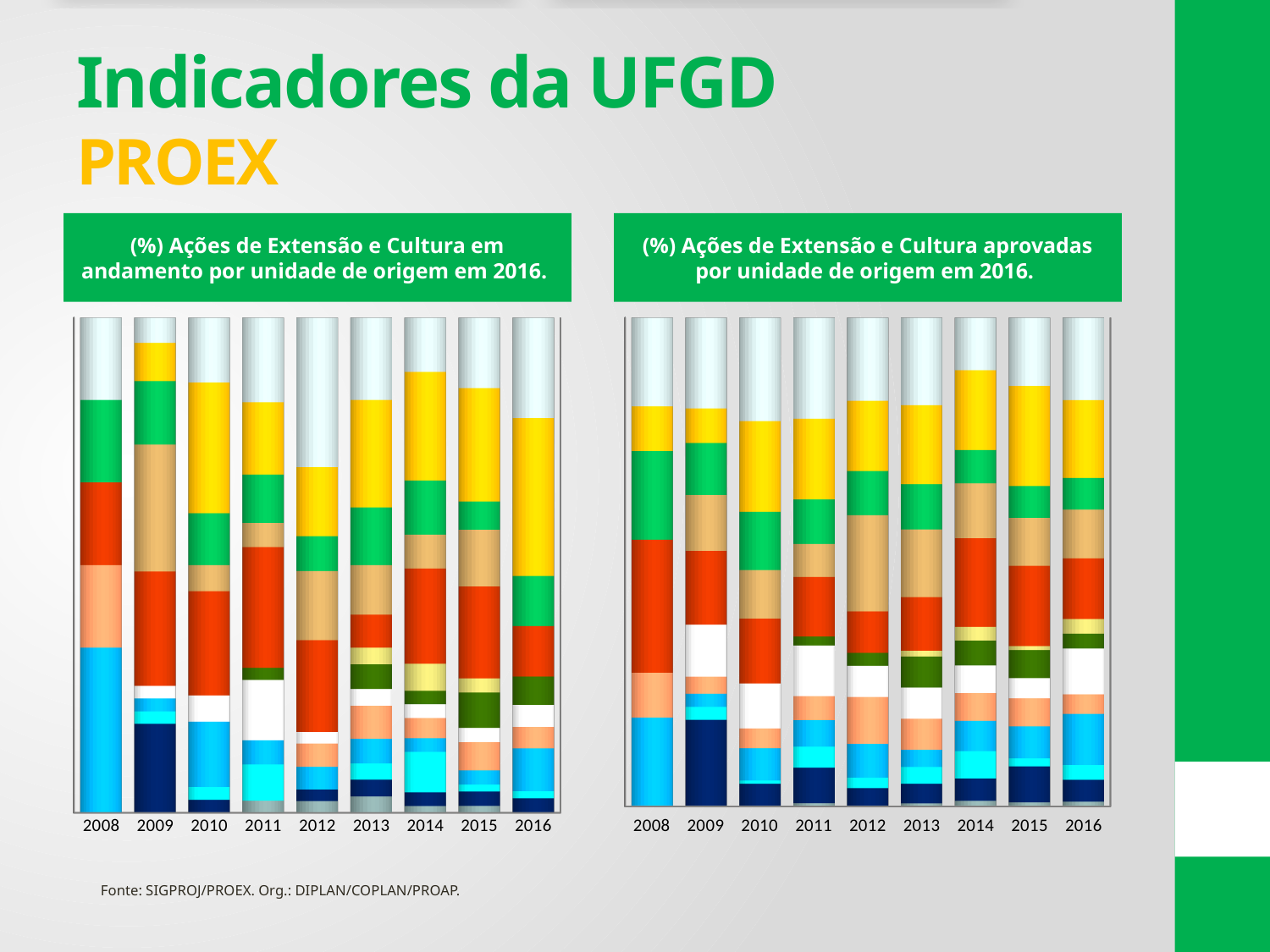
What kind of chart is the right chart, '(%) Ações de Extensão e Cultura aprovadas por unidade de origem em 2016'? Stacked bar chart How many charts are shown on the slide? 2 What is the title of the chart on the right side of the slide? (%) Ações de Extensão e Cultura aprovadas por unidade de origem em 2016. What kind of chart is the left chart, '(%) Ações de Extensão e Cultura em andamento por unidade de origem em 2016'? Stacked bar chart In the right chart, what is the last year shown on the x axis? 2016 In the left chart, what is the first year shown on the x axis? 2008 In the left chart, how many years are shown on the x axis? 9 In the right chart, how many bars are plotted? 9 What is the title of the chart on the left side of the slide? (%) Ações de Extensão e Cultura em andamento por unidade de origem em 2016. In the left chart, which year comes immediately after 2012 on the x axis? 2013